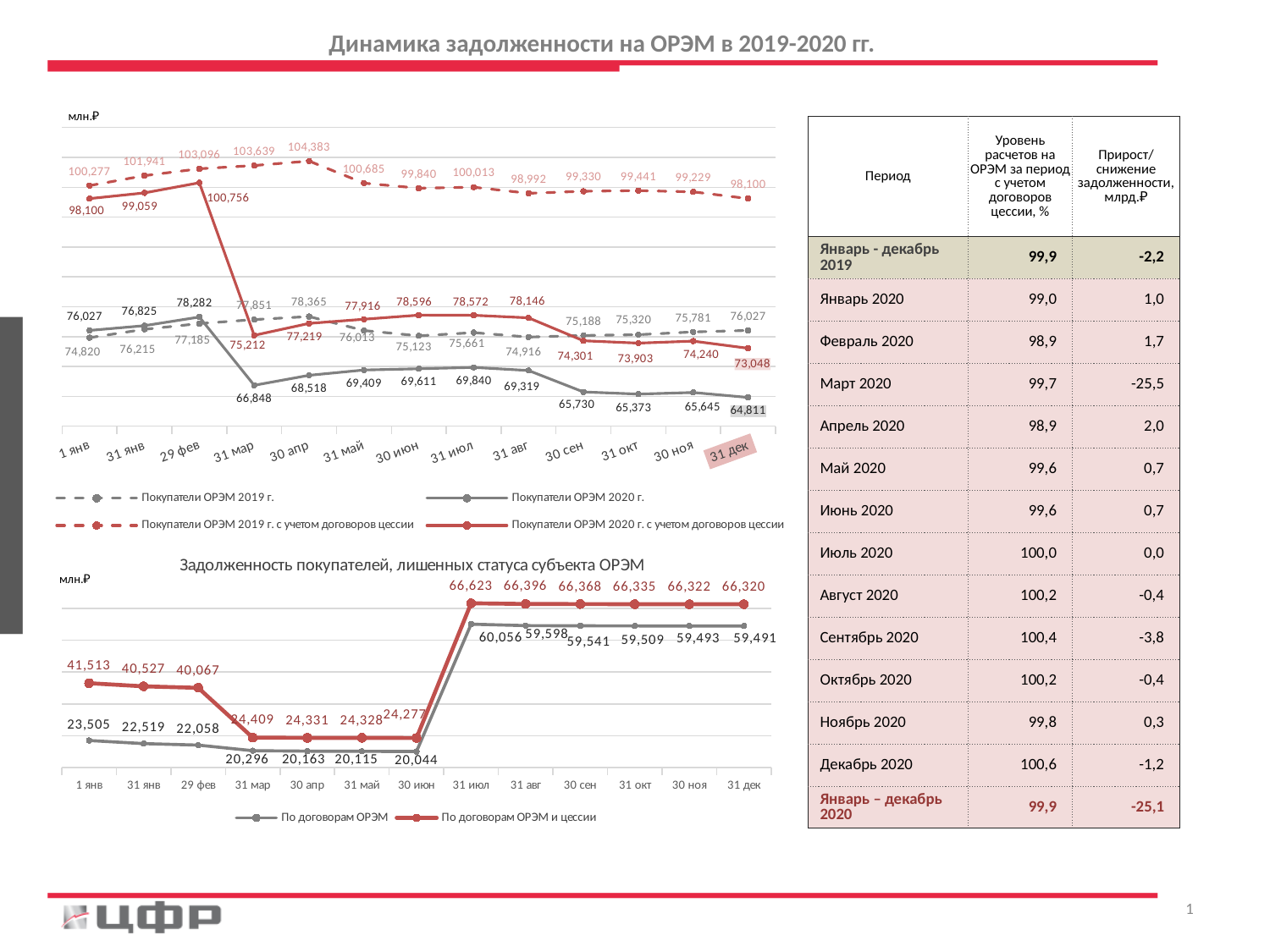
In the chart 'Задолженность покупателей, лишенных статуса субъекта ОРЭМ', which is larger on 1 янв: По договорам ОРЭМ or По договорам ОРЭМ и цессии? По договорам ОРЭМ и цессии What kind of chart is the chart titled 'Задолженность покупателей, лишенных статуса субъекта ОРЭМ'? line chart In the top chart, on which date is the Покупатели ОРЭМ 2020 г. series lowest? 31 дек How many dates are plotted along the x axis of the top chart? 13 In the top chart, on which date does the Покупатели ОРЭМ 2019 г. с учетом договоров цессии series reach its highest value? 30 апр In the top chart, what is the value for Покупатели ОРЭМ 2020 г. с учетом договоров цессии on 29 фев? 100,756 In the top chart, what is the value for Покупатели ОРЭМ 2020 г. on 31 дек? 64,811 In the chart 'Задолженность покупателей, лишенных статуса субъекта ОРЭМ', what is the difference between По договорам ОРЭМ и цессии (66,320) and По договорам ОРЭМ (59,491) on 31 дек? 6,829 In the chart 'Задолженность покупателей, лишенных статуса субъекта ОРЭМ', does the По договорам ОРЭМ series rise or fall from 1 янв to 30 июн? fall In the chart 'Задолженность покупателей, лишенных статуса субъекта ОРЭМ', what is the value for По договорам ОРЭМ и цессии on 31 июл? 66,623 In the top chart, what is the difference between Покупатели ОРЭМ 2020 г. с учетом договоров цессии on 29 фев (100,756) and on 31 мар (75,212)? 25,544 How many series does the legend of the top chart list? 4